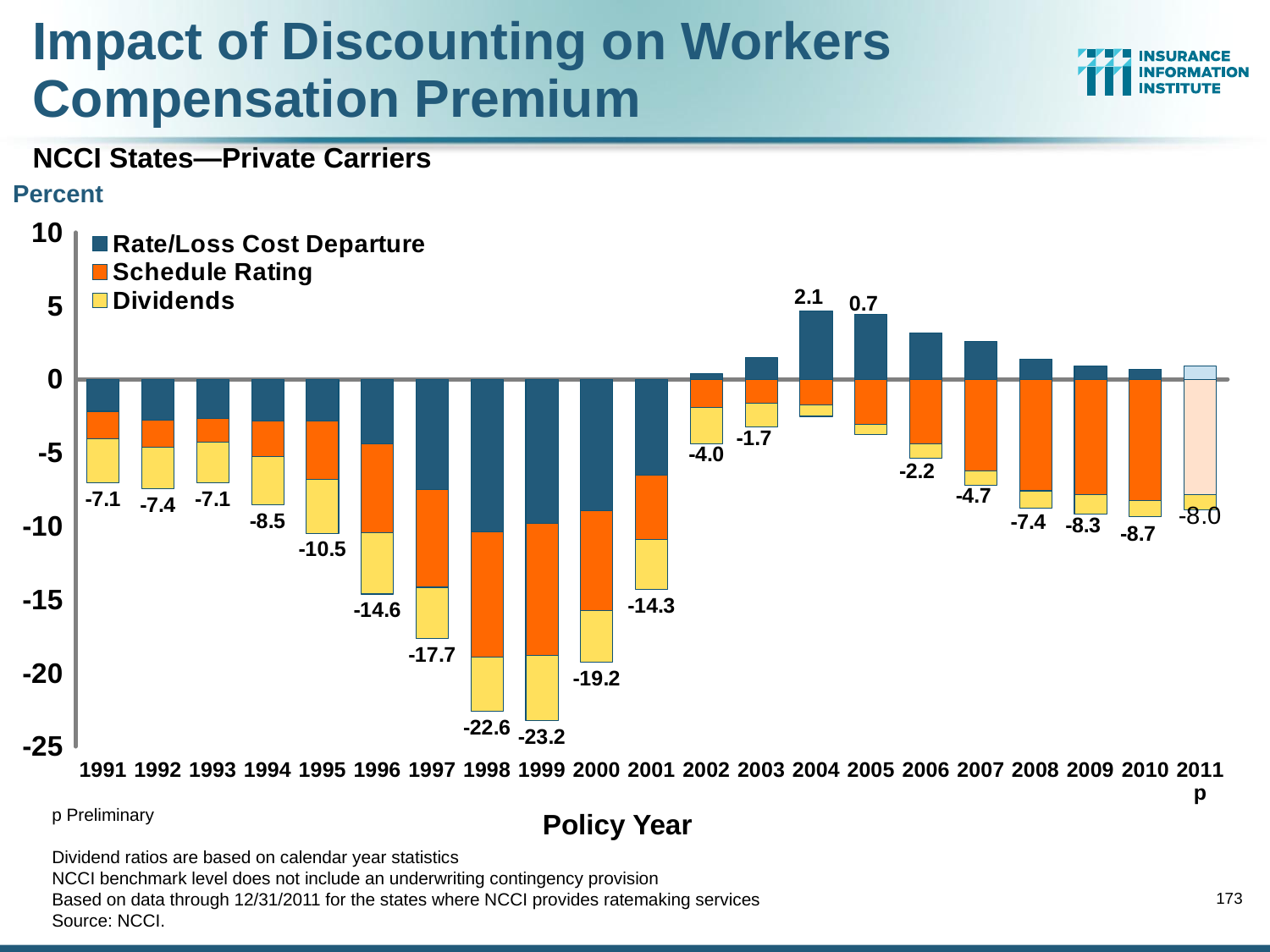
What is the difference between the labeled net values for 1998 and 1999? 0.6 What is the labeled net value for policy year 1999? -23.2 Which policy year has a more negative labeled net value, 1997 or 2000? 2000 Which policy year has the highest labeled net value? 2004 What kind of chart is shown on the slide? Stacked bar chart How many policy years are shown on the x axis? 21 Which policy year has the lowest (most negative) labeled net value? 1999 What is the labeled net value for policy year 2004? 2.1 What is the labeled net value for policy year 2011p? -8.0 What is the title of the x axis? Policy Year How many series does the legend list? 3 Do the labeled net values rise or fall from 1991 to 1999? Fall